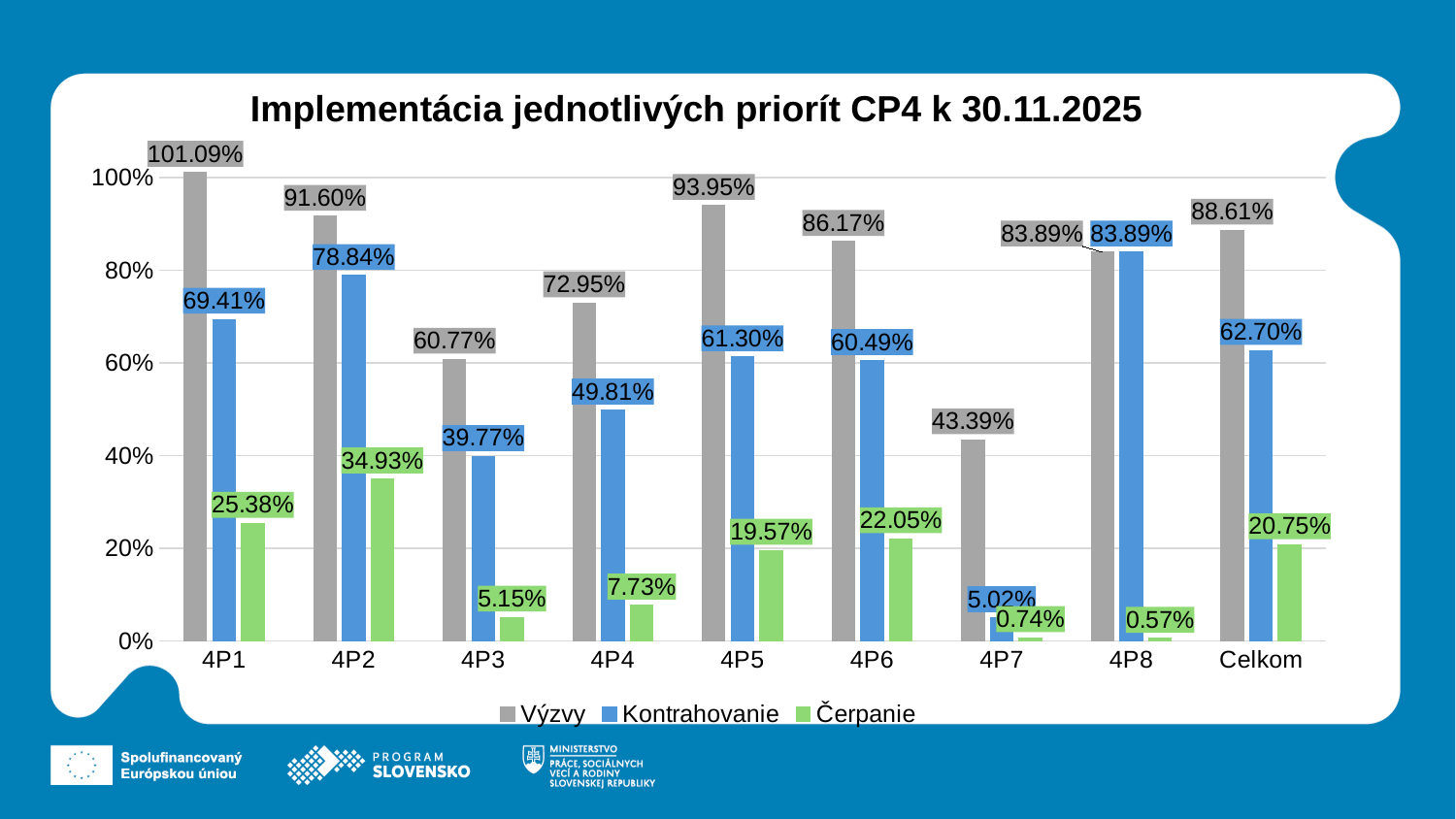
How many series does the legend list? 3 Which category has the lowest Čerpanie value? 4P8 Is the Výzvy value for 4P7 greater or less than 60%? less What is the Výzvy value for 4P5? 93.95% What is the Čerpanie value for Celkom? 20.75% What is the Kontrahovanie value for 4P4? 49.81% What kind of chart is shown on the slide? bar chart What is the title of the chart? Implementácia jednotlivých priorít CP4 k 30.11.2025 Which category has the highest Výzvy value? 4P1 How many categories are shown on the x axis? 9 Which is larger, the Kontrahovanie value for 4P1 or for 4P2? 4P2 What is the difference between the Výzvy and Kontrahovanie values for 4P2? 12.76%